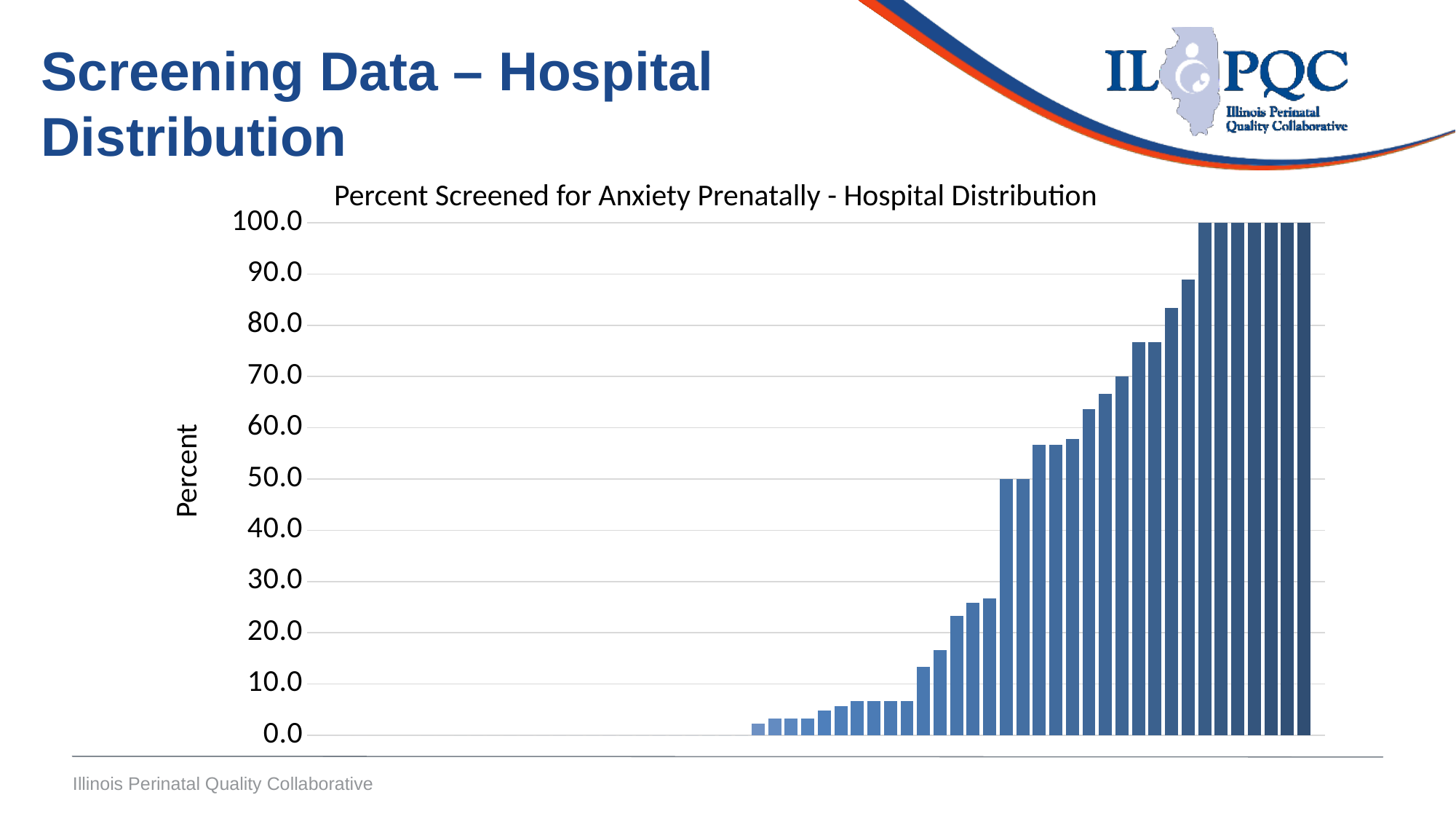
What kind of chart is shown on the slide? Bar chart What is the highest tick value shown on the vertical axis? 100.0 Do the bar values rise or fall from left to right across the chart? Rise What is the label on the vertical axis of the chart? Percent Is the value of the tallest bar greater or less than 90.0? greater Is the value of the shortest visible bar greater or less than 10.0? less What value do the tallest bars in the chart reach? 100.0 What is the title of the chart? Percent Screened for Anxiety Prenatally - Hospital Distribution